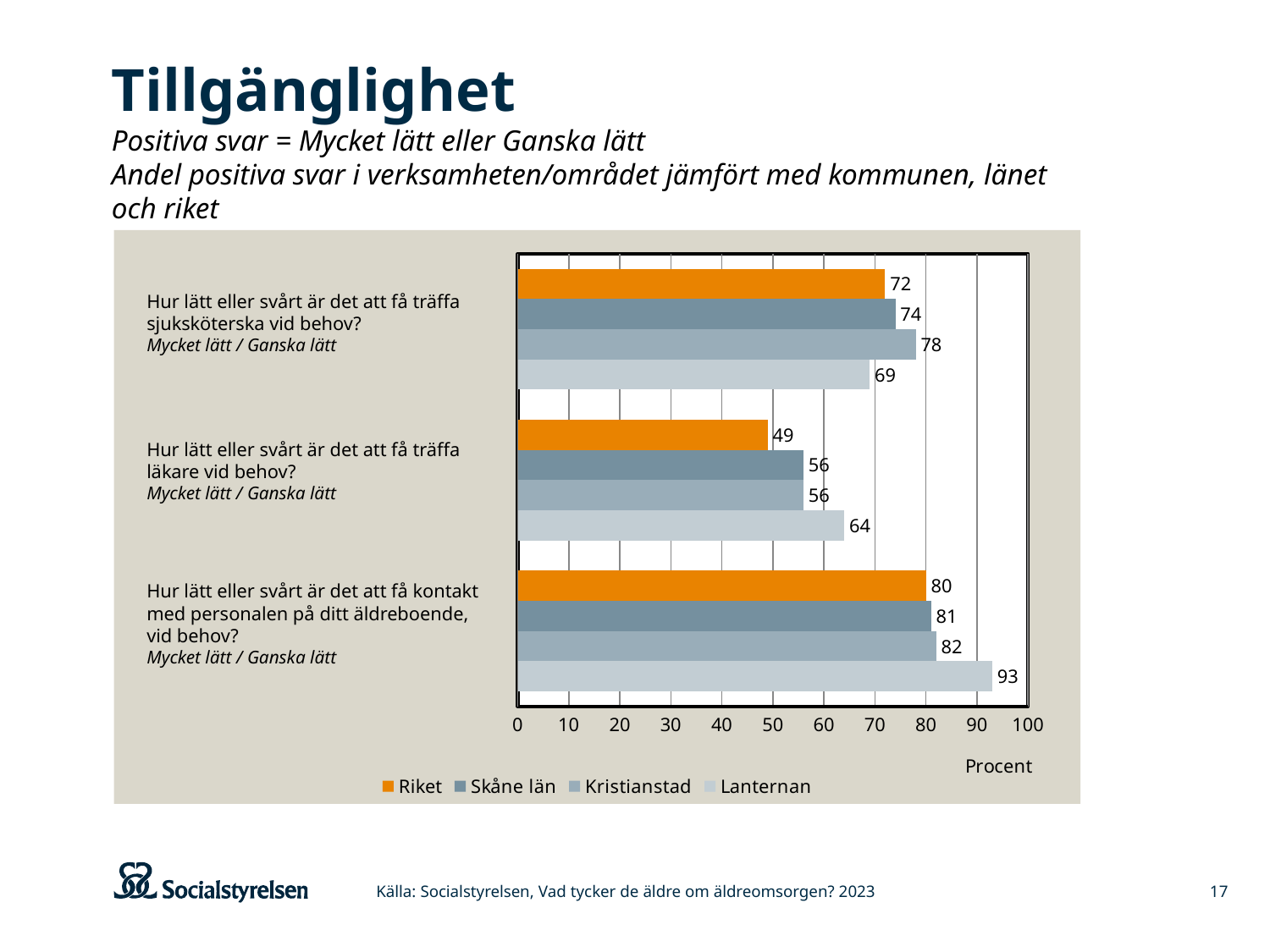
Which series is shown in orange in the legend? Riket What is the value for Lanternan on the question about getting in contact with staff at the care home (kontakt med personalen)? 93 What is the value for Riket on the question about meeting a doctor (träffa läkare vid behov)? 49 What is the value for Kristianstad on the question about meeting a nurse (träffa sjuksköterska vid behov)? 78 What is the label on the x axis of the chart? Procent On the question about meeting a nurse, which is larger: Skåne län or Lanternan? Skåne län What kind of chart is shown on the slide? Bar chart Which series has the highest value on the question about meeting a nurse (träffa sjuksköterska vid behov)? Kristianstad What is the difference between Lanternan and Riket on the question about getting in contact with staff at the care home? 13 Which series has the lowest value on the question about meeting a doctor (träffa läkare vid behov)? Riket How many series does the legend list? 4 How many question categories are plotted on the chart? 3